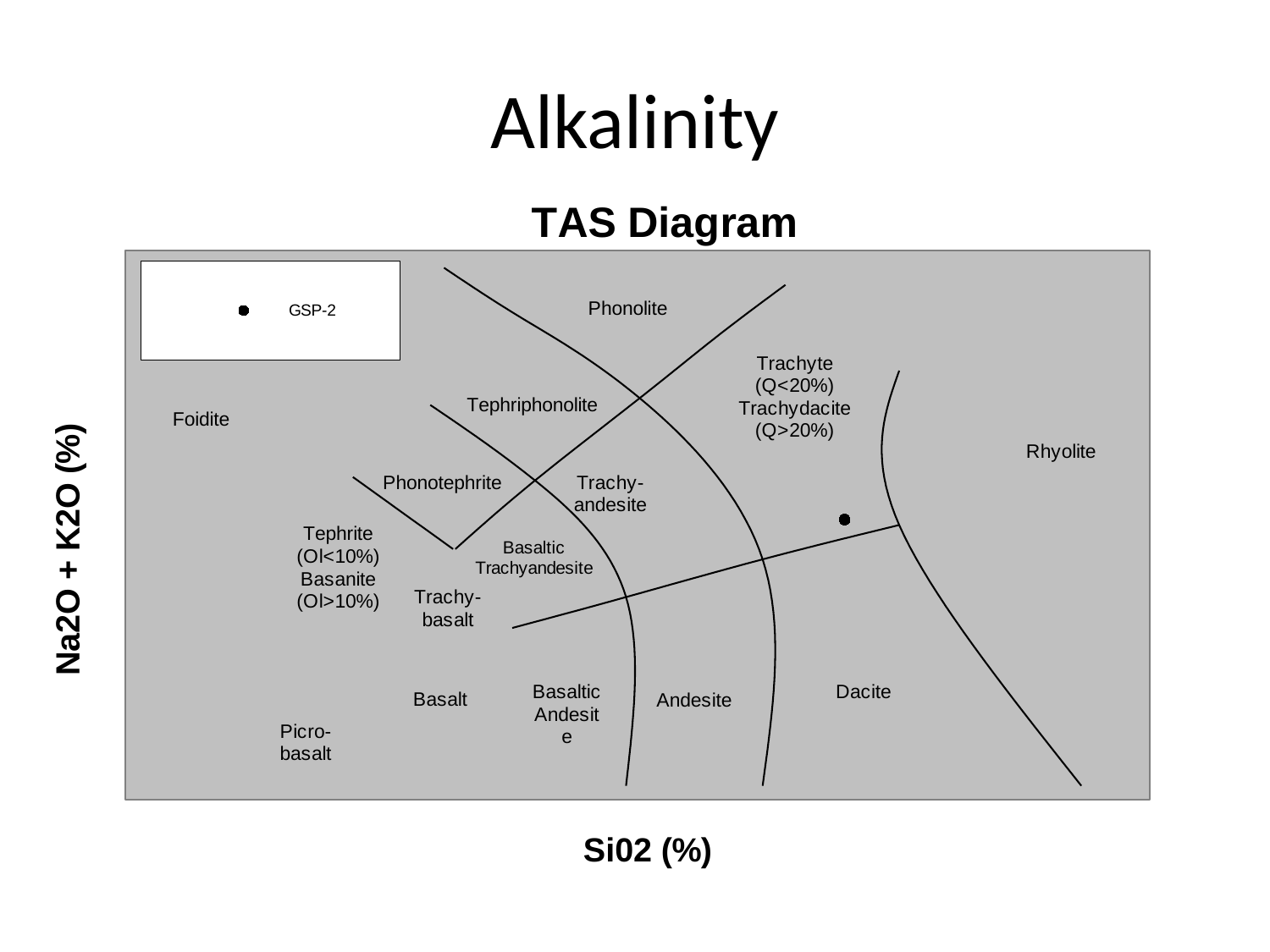
What is the title of the chart on the slide? TAS Diagram In which labelled rock field does the GSP-2 point fall on the TAS Diagram? Trachyte / Trachydacite How many series does the legend of the TAS Diagram list? 1 What kind of chart is the TAS Diagram? scatter plot What is the name of the series shown in the legend of the TAS Diagram? GSP-2